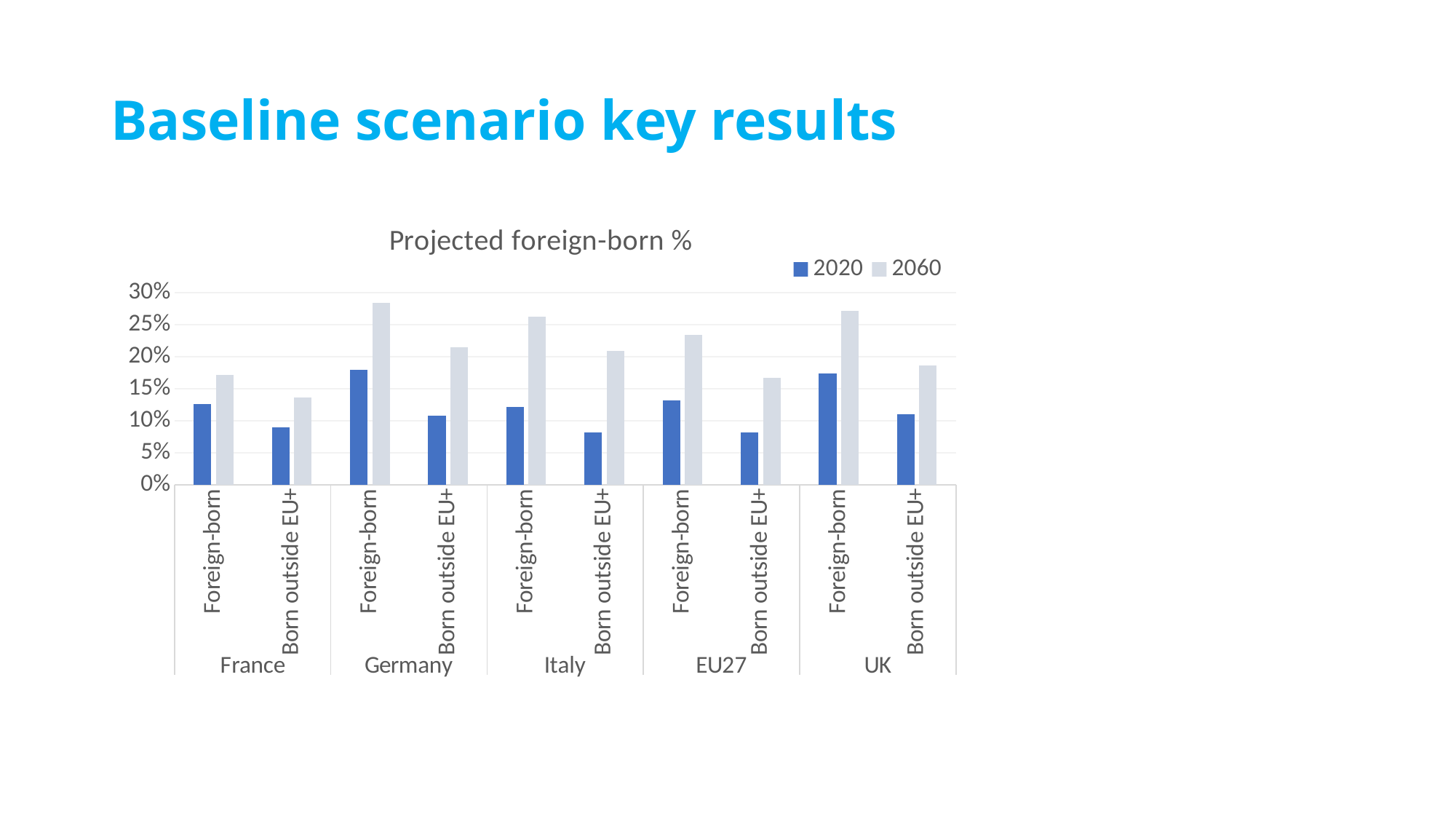
Is the 2020 value for France Born outside EU+ greater or less than 10%? less For Italy Foreign-born, is the 2060 value higher or lower than the 2020 value? higher Is the 2060 value for Italy Foreign-born greater or less than 25%? greater Which is larger: the 2060 value for UK Foreign-born or the 2060 value for EU27 Foreign-born? UK Foreign-born What type of chart is shown on the slide? Bar chart Is the 2060 value for Germany Foreign-born greater or less than 25%? greater What is the title of the chart? Projected foreign-born % Which category has the highest 2060 value? Germany Foreign-born Which category has the lowest 2060 value? France Born outside EU+ How many countries or regions are shown along the x axis? 5 How many series does the legend list? 2